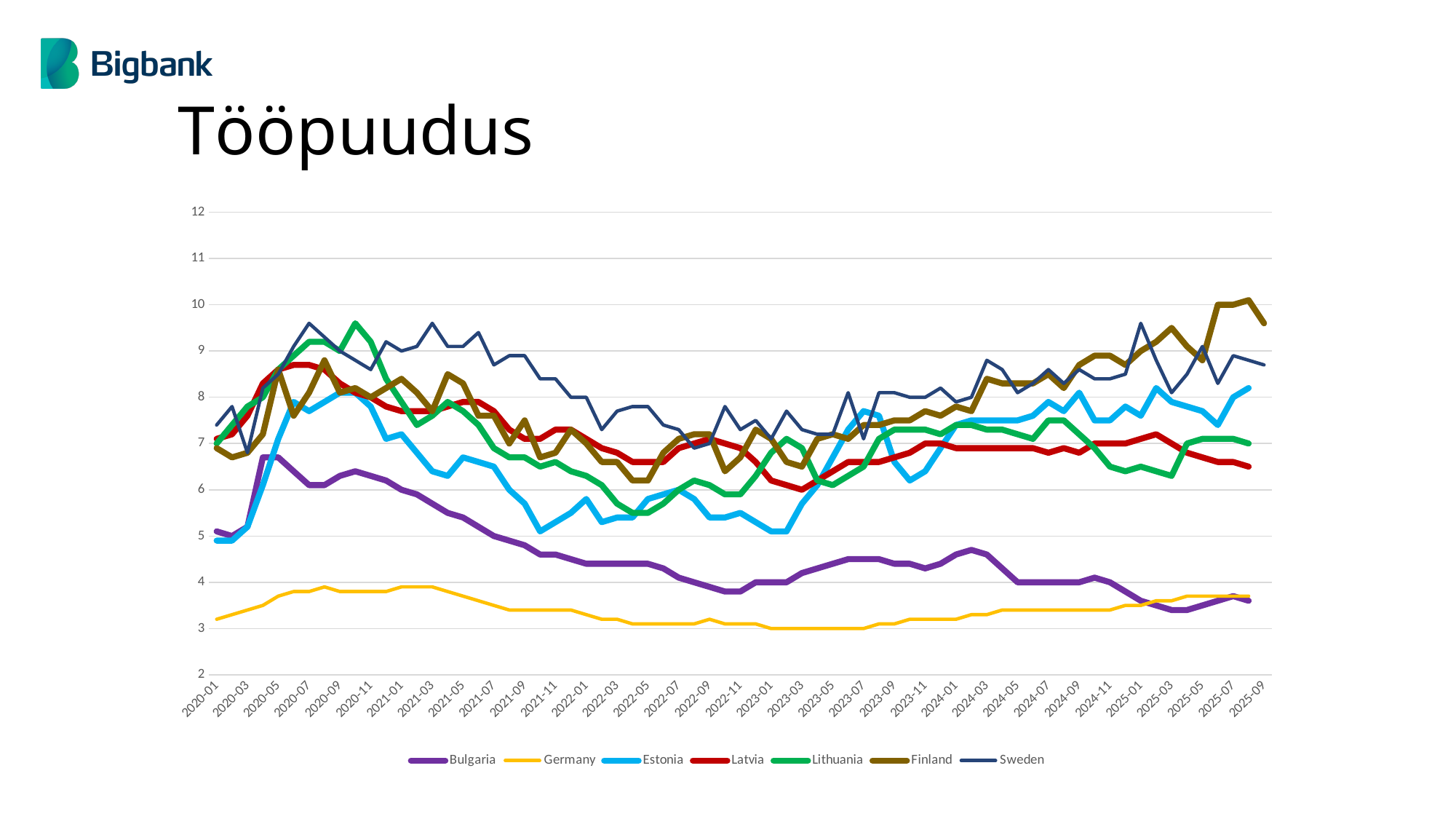
Does the value for Bulgaria rise or fall between 2020-05 and 2022-11? fall Which series has the highest value at 2025-09? Finland Which series is drawn in yellow in the chart? Germany Which series has the lowest value at 2022-01? Germany What kind of chart is shown on the slide? line chart What is the title of the slide's chart? Tööpuudus Is the value for Finland at 2025-07 greater or less than 9? greater Is the value for Estonia at 2023-01 greater or less than 6? less How many series does the legend list? 7 Is the value for Sweden at 2020-07 greater or less than 9? greater